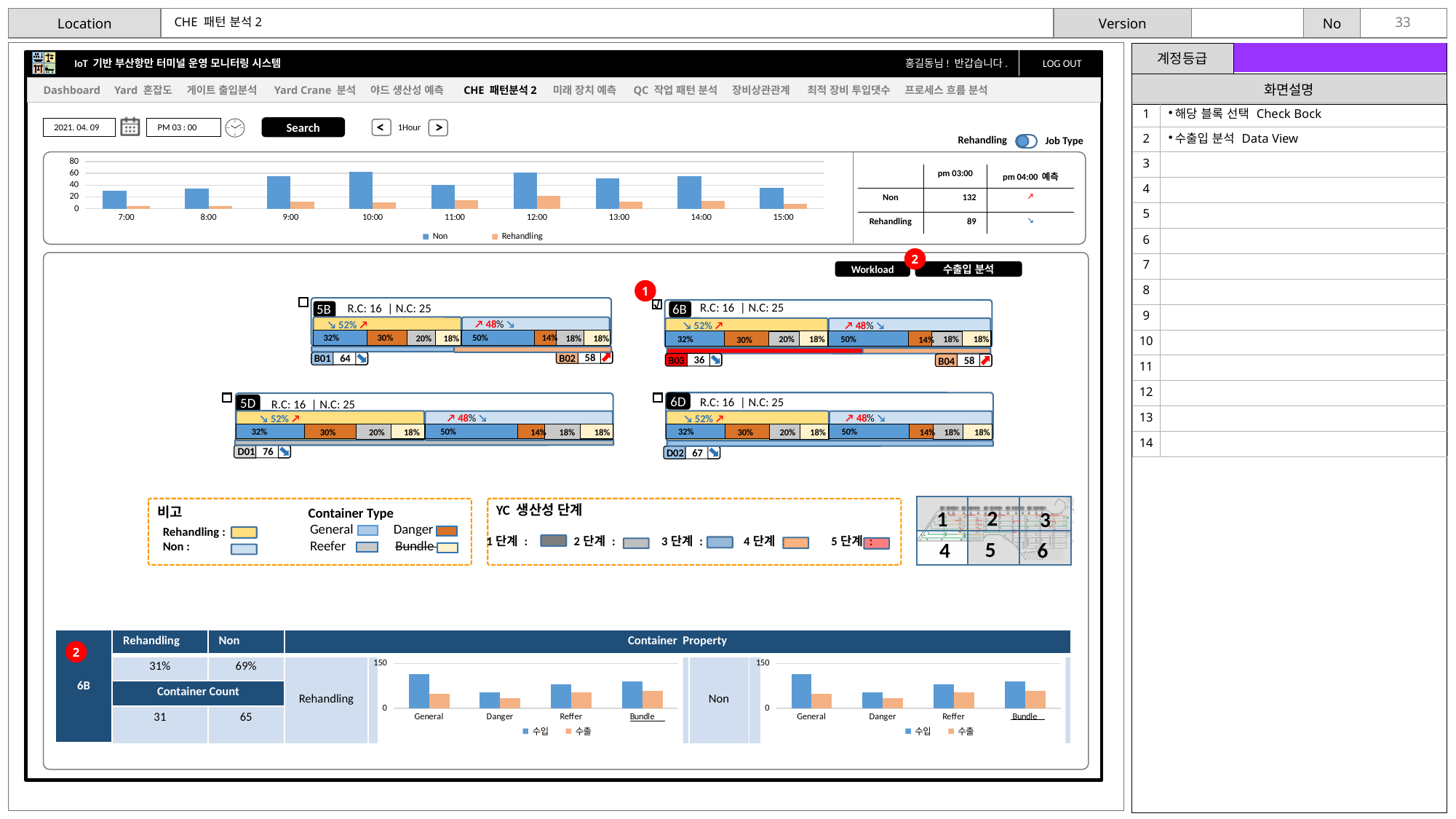
In the top hourly chart, at which hour is the Rehandling value highest? 12:00 In the top hourly chart, which is larger at 12:00, Non or Rehandling? Non In the top hourly chart, how many time categories are shown on the x axis? 9 In the top hourly chart, is the Rehandling value at 12:00 greater or less than 40? less In the top hourly chart, which is larger for Non, 10:00 or 11:00? 10:00 In the top hourly chart, is the Non value at 7:00 greater or less than 40? less In the bottom-left Rehandling Container Property chart, how many categories are on the x axis? 4 In the bottom-left Rehandling Container Property chart, which category has the highest 수입 value? General In the bottom-right Non Container Property chart, which is larger for General, 수입 or 수출? 수입 In the top hourly chart, how many series does the legend list? 2 In the top hourly chart, what kind of chart is it? bar chart In the top hourly chart, is the Non value at 10:00 greater or less than 40? greater